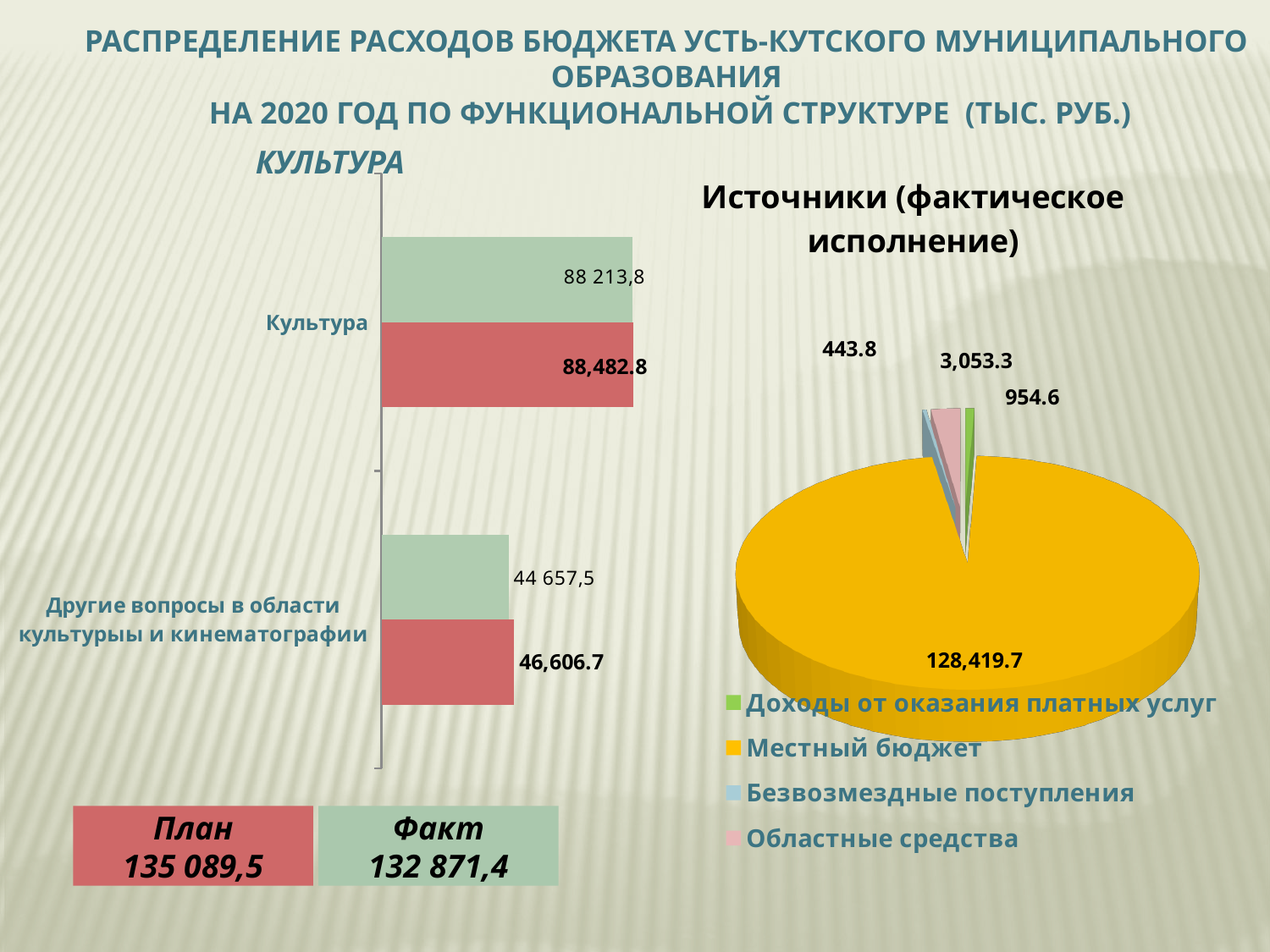
How many categories are shown on the "Культура" bar chart? 2 In the "Культура" bar chart, what is the value of the green (Факт) bar for the category "Культура"? 88 213,8 In the "Культура" bar chart, what is the value of the red (План) bar for "Другие вопросы в области культурыы и кинематографии"? 46,606.7 In the "Культура" bar chart, what is the difference between the red (План) bar and the green (Факт) bar for "Другие вопросы в области культурыы и кинематографии"? 1,949.2 In the pie chart "Источники (фактическое исполнение)", what is the value for "Областные средства"? 3,053.3 In the pie chart "Источники (фактическое исполнение)", which source has the largest slice? Местный бюджет In the pie chart "Источники (фактическое исполнение)", what is the value for "Местный бюджет"? 128,419.7 What kind of chart is the chart titled "Источники (фактическое исполнение)" on the right of the slide? pie chart In the "Культура" bar chart, which is larger for the category "Культура": the red (План) bar or the green (Факт) bar? the red (План) bar In the pie chart "Источники (фактическое исполнение)", which source has the smallest slice? Безвозмездные поступления How many entries does the legend of the pie chart "Источники (фактическое исполнение)" list? 4 What kind of chart is the chart titled "Культура" on the left of the slide? bar chart